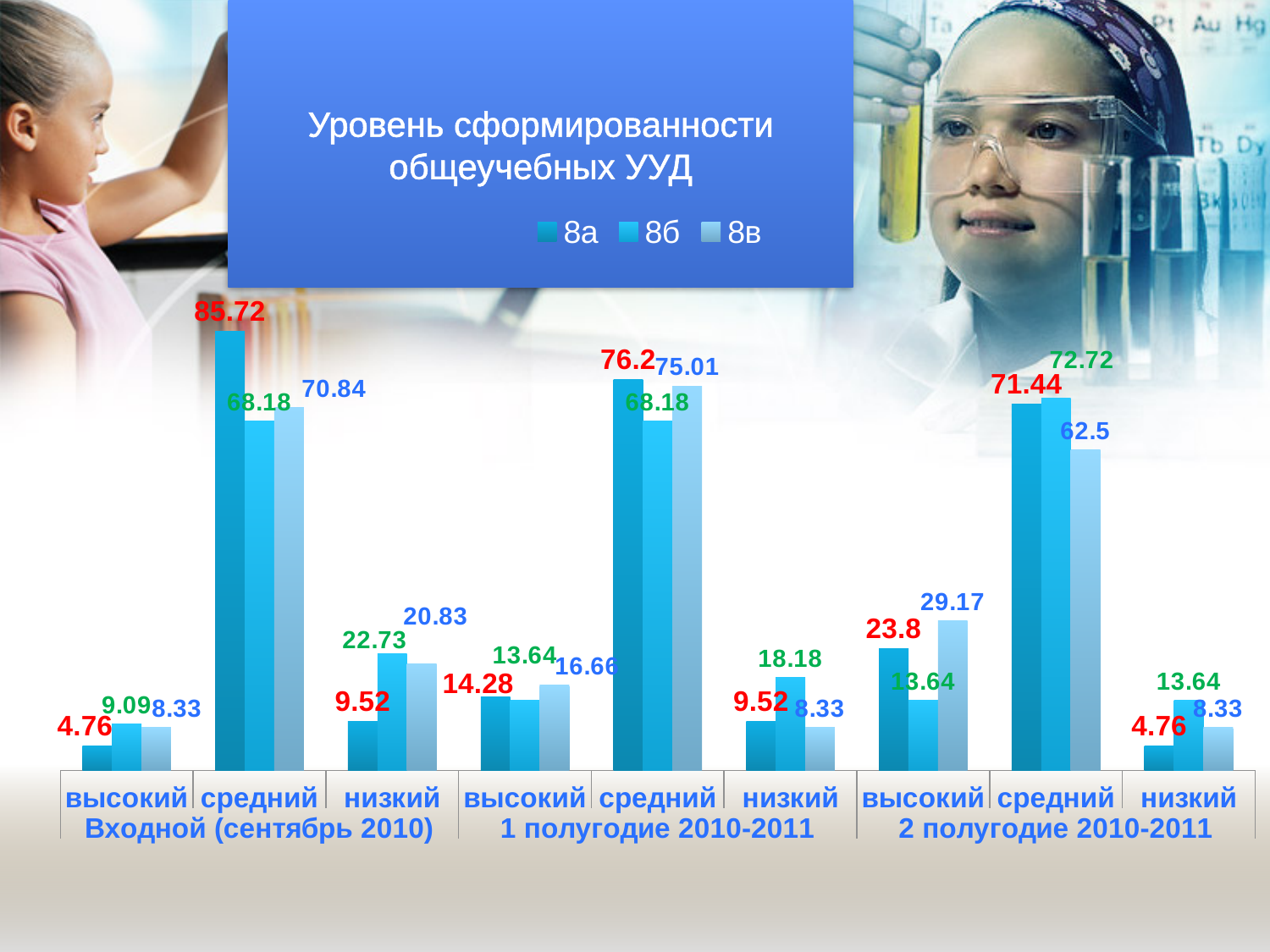
Which series has the lowest value in the низкий category of Входной (сентябрь 2010)? 8а What type of chart is shown on the slide? bar chart How many series does the legend list? 3 What is the value for 8б in the высокий category of 1 полугодие 2010-2011? 13.64 What is the value for 8а in the средний category of Входной (сентябрь 2010)? 85.72 What is the value for 8в in the низкий category of 2 полугодие 2010-2011? 8.33 In the средний category of 2 полугодие 2010-2011, which is larger: the value for 8а or for 8в? 8а How many period groups are shown on the x axis? 3 What is the difference between the 8а and 8б values in the средний category of Входной (сентябрь 2010)? 17.54 Which series has the highest value in the высокий category of 2 полугодие 2010-2011? 8в How does the 8а value in the высокий category change from Входной (сентябрь 2010) to 2 полугодие 2010-2011? rises What is the title of the chart? Уровень сформированности общеучебных УУД